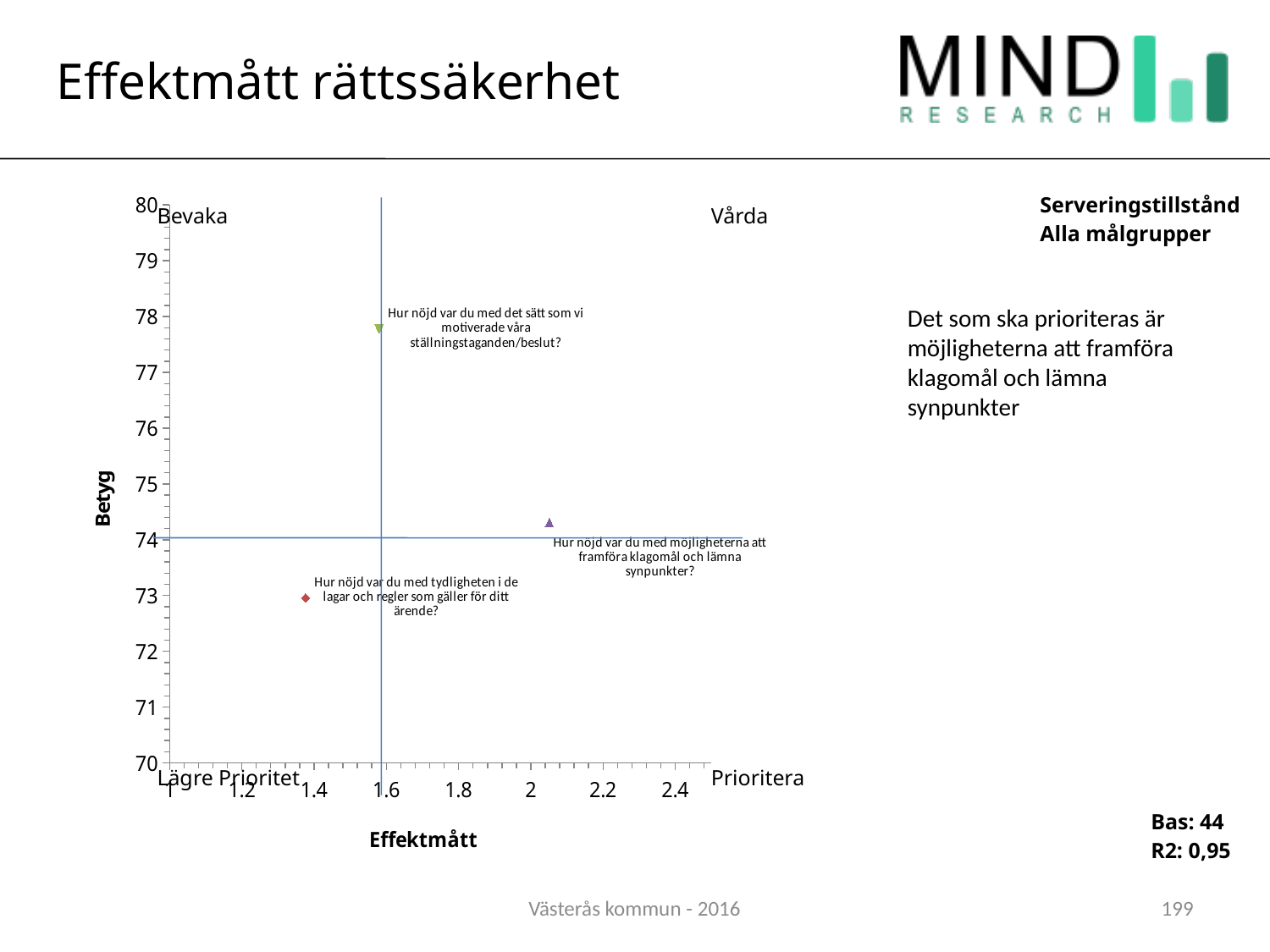
What is the title of the vertical axis of the chart? Betyg Which question has the highest Effektmått value in the chart? Hur nöjd var du med möjligheterna att framföra klagomål och lämna synpunkter? Which question has the lowest Effektmått value in the chart? Hur nöjd var du med tydligheten i de lagar och regler som gäller för ditt ärende? Is the Betyg value for 'Hur nöjd var du med tydligheten i de lagar och regler som gäller för ditt ärende?' greater or less than 74? less Which question has the lowest Betyg value in the chart? Hur nöjd var du med tydligheten i de lagar och regler som gäller för ditt ärende? How many data points are plotted in the chart? 3 Which question has the highest Betyg value in the chart? Hur nöjd var du med det sätt som vi motiverade våra ställningstaganden/beslut? Which has a higher Betyg value: 'Hur nöjd var du med möjligheterna att framföra klagomål och lämna synpunkter?' or 'Hur nöjd var du med tydligheten i de lagar och regler som gäller för ditt ärende?' Hur nöjd var du med möjligheterna att framföra klagomål och lämna synpunkter? What is the title of the horizontal axis of the chart? Effektmått What kind of chart is shown on the slide? scatter chart Is the Effektmått value for 'Hur nöjd var du med möjligheterna att framföra klagomål och lämna synpunkter?' greater or less than 2? greater Is the Betyg value for 'Hur nöjd var du med det sätt som vi motiverade våra ställningstaganden/beslut?' greater or less than 77? greater